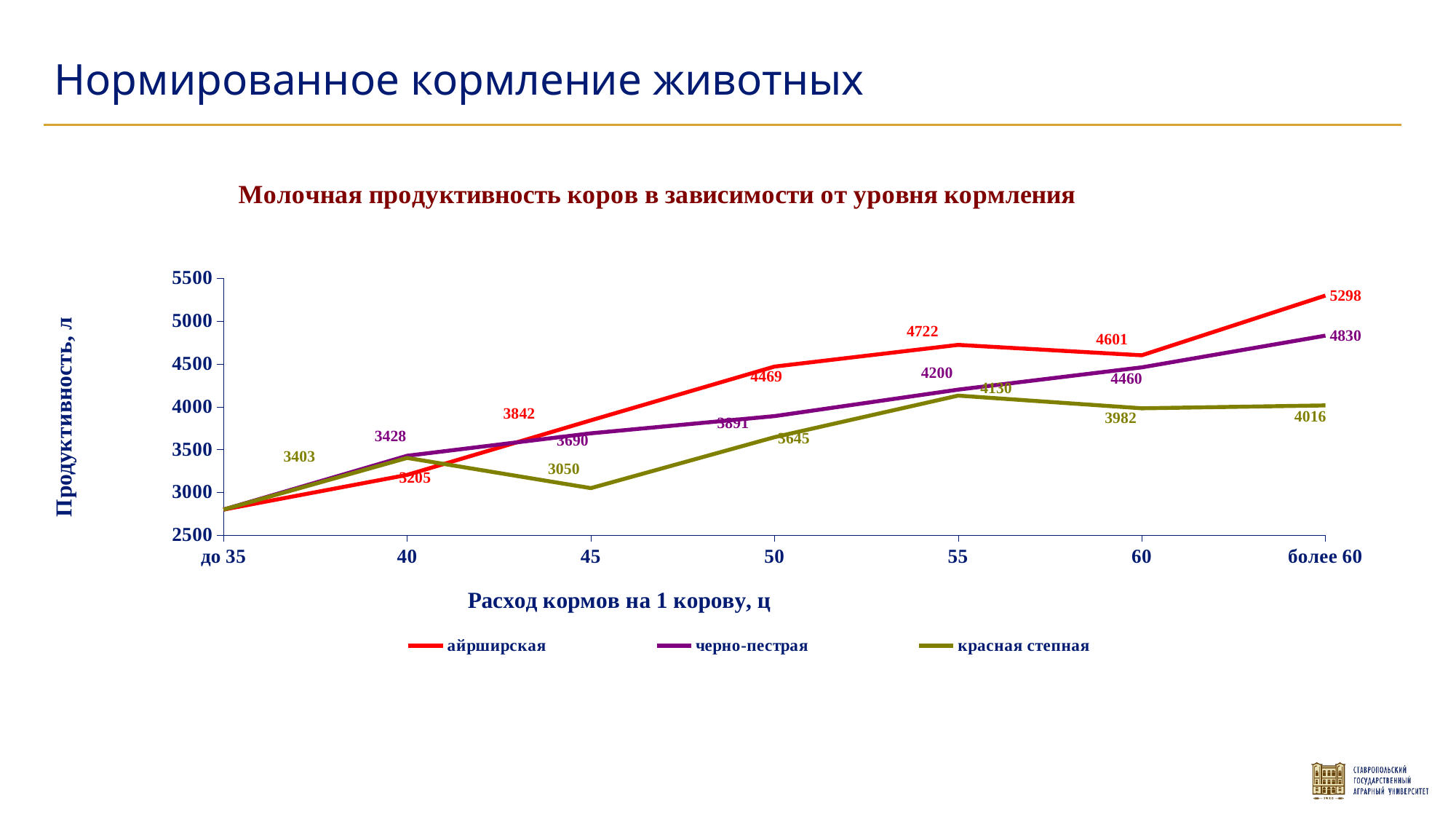
Is the value for айрширская at до 35 greater or less than 3000? less What is the value for черно-пестрая at 55? 4200 Which series has the highest value at более 60? айрширская How many categories are on the x axis? 7 How many series does the legend list? 3 What kind of chart is shown on the slide? line chart Do the values for черно-пестрая rise or fall along the x axis? rise At 60, which is larger: айрширская or красная степная? айрширская What is the y-axis title of the chart? Продуктивность, л What is the value for красная степная at 45? 3050 What is the difference between айрширская and черно-пестрая at более 60? 468 What is the value for айрширская at более 60? 5298